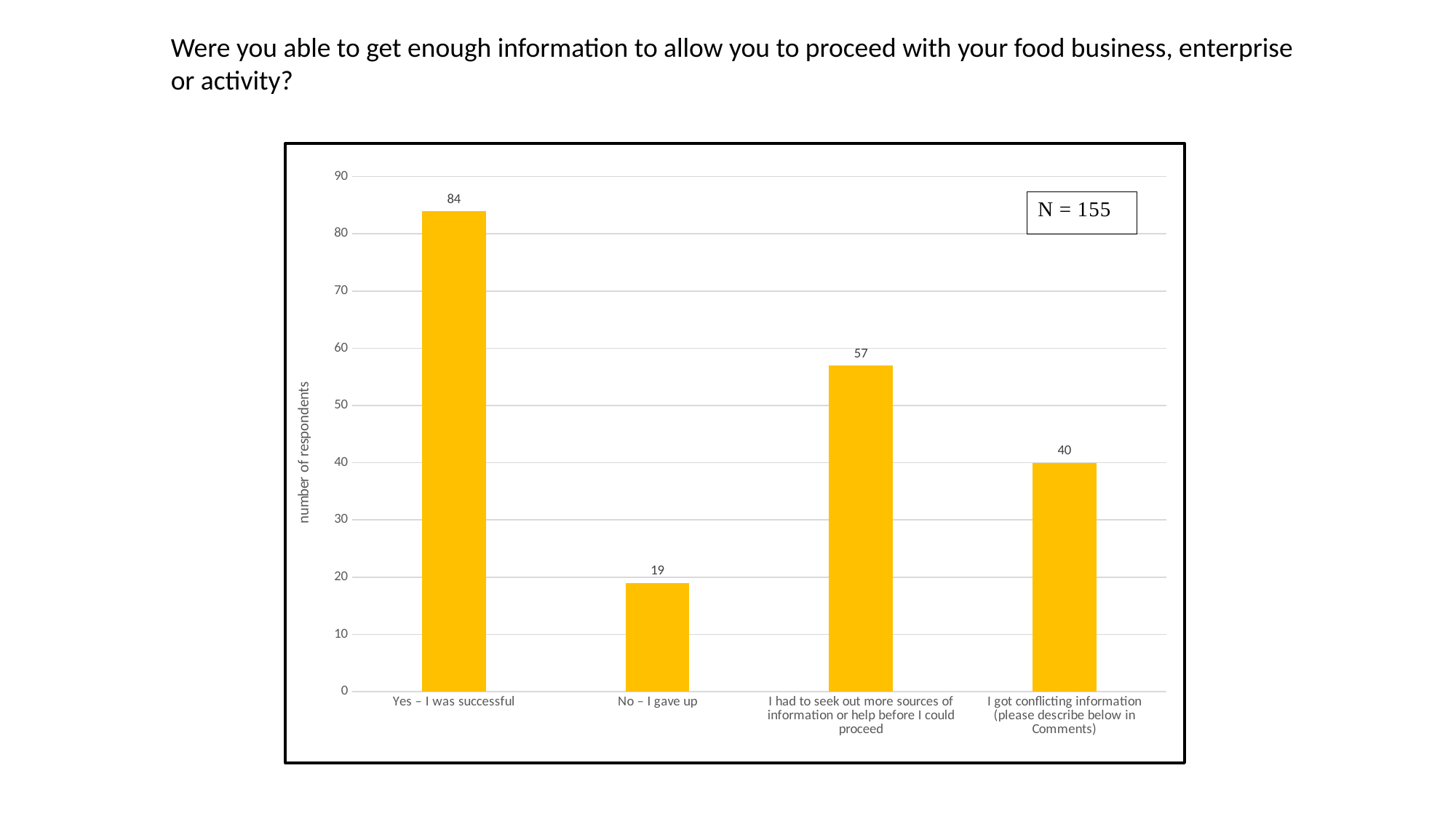
Which response category has the lowest number of respondents? No – I gave up What is the label of the vertical axis? number of respondents What is the difference between the number of respondents for "Yes – I was successful" and "No – I gave up"? 65 How many respondents answered "Yes – I was successful"? 84 What is the difference between the values for "I had to seek out more sources of information or help before I could proceed" and "I got conflicting information"? 17 Which has more respondents: "I got conflicting information" or "No – I gave up"? I got conflicting information How many respondents answered "No – I gave up"? 19 Which response category has the highest number of respondents? Yes – I was successful What is the value for "I got conflicting information (please describe below in Comments)"? 40 What kind of chart is shown on the slide? Bar chart How many response categories are shown on the chart? 4 What is the value for "I had to seek out more sources of information or help before I could proceed"? 57